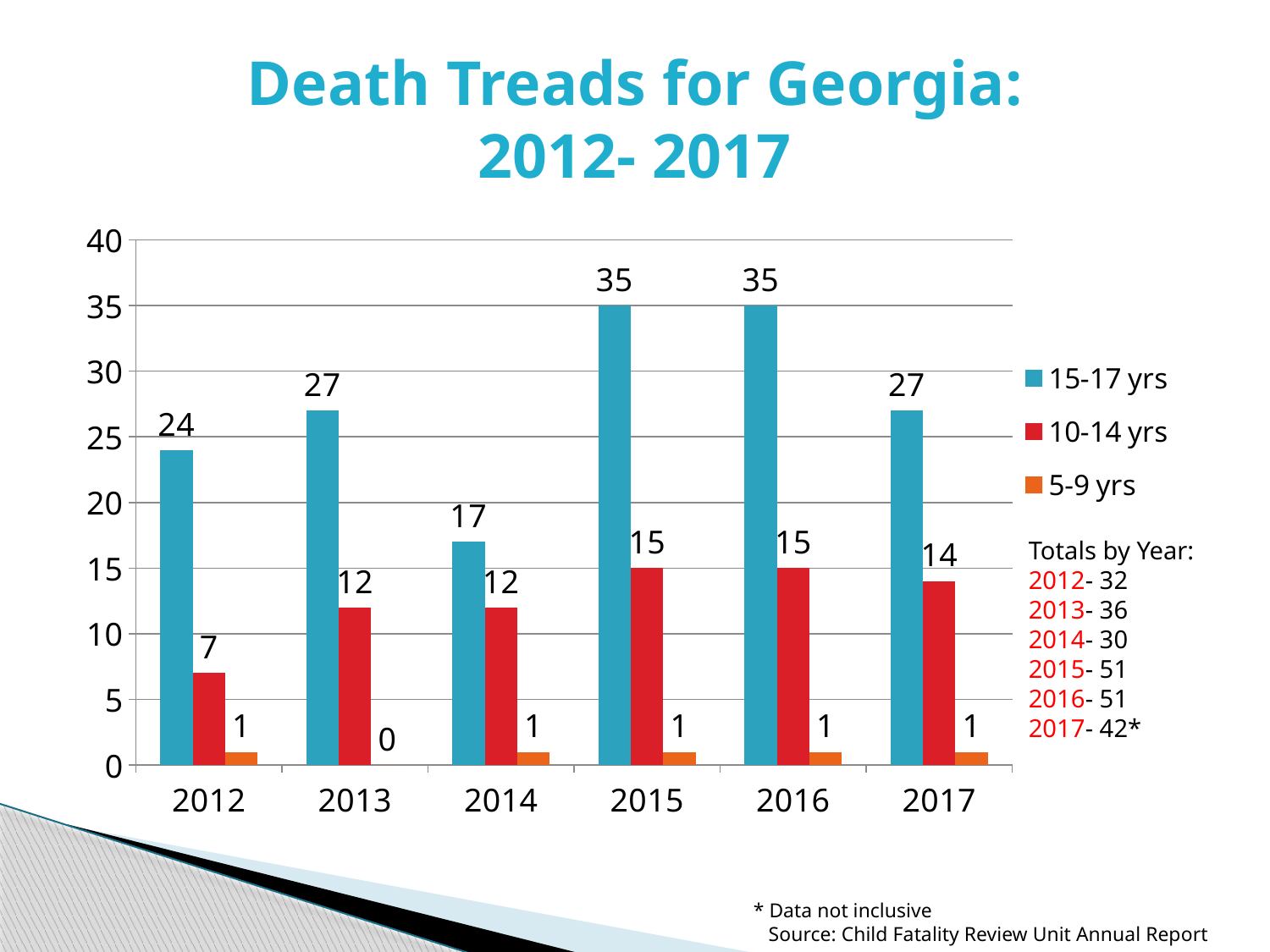
How many series does the legend list? 3 What kind of chart is shown on the slide? bar chart Which colour represents the 5-9 yrs series in the legend? orange Does the 15-17 yrs value rise or fall from 2016 to 2017? fall In which year is the 10-14 yrs value lowest? 2012 What is the value for the 5-9 yrs series in 2013? 0 Which is larger, the 10-14 yrs value in 2013 or in 2017? 2017 What is the value for the 10-14 yrs series in 2017? 14 How many years are shown on the x axis? 6 What is the value for the 15-17 yrs series in 2012? 24 What is the difference between the 15-17 yrs values for 2015 and 2014? 18 In which year is the 15-17 yrs value lowest? 2014